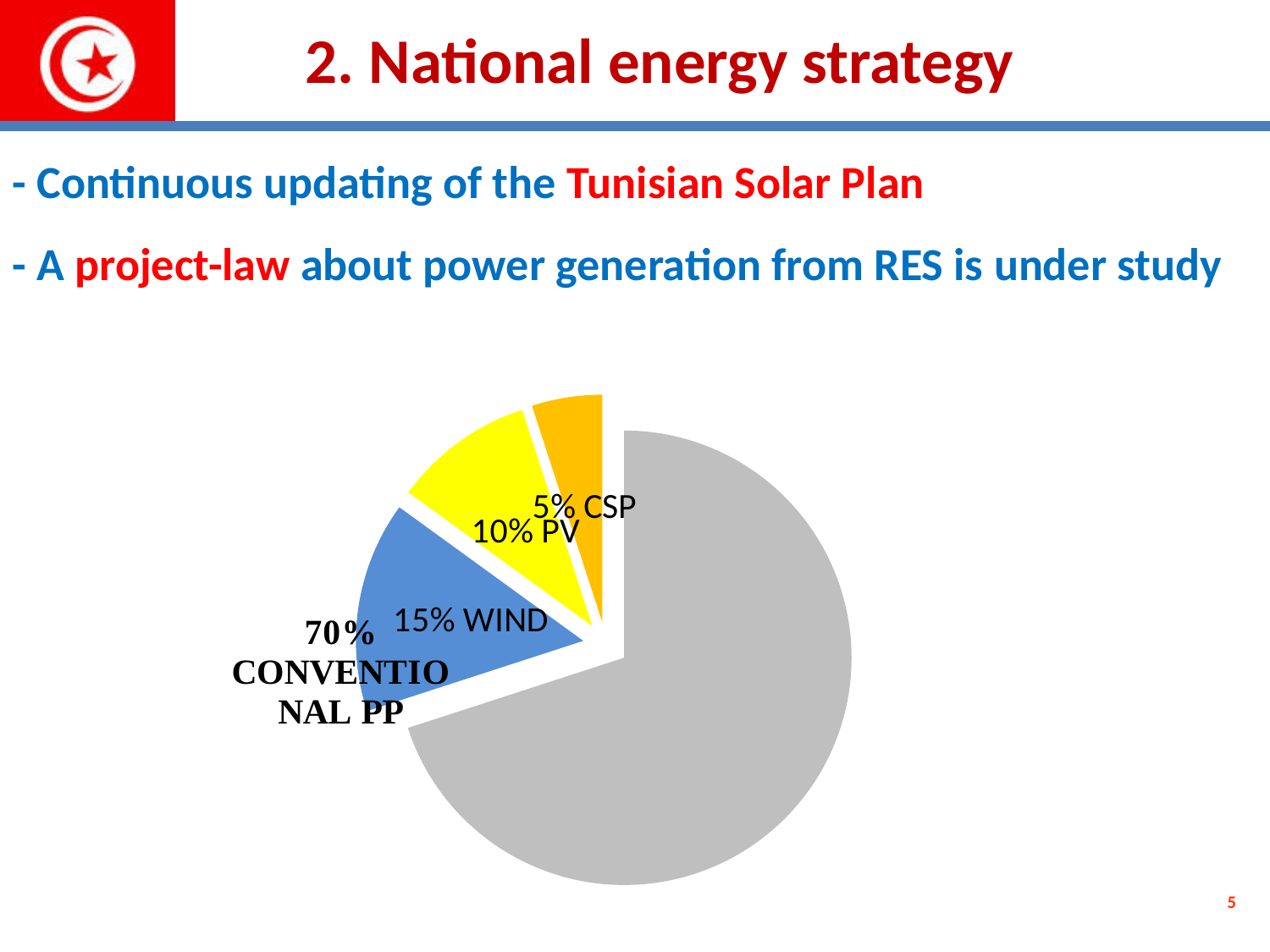
What share of the pie does WIND have? 15% What is the difference in percentage points between the CONVENTIONAL PP share and the WIND share? 55% Which slice of the pie is the smallest? CSP What share of the pie does CONVENTIONAL PP have? 70% What is the difference in percentage points between the WIND share and the PV share? 5% Which slice of the pie is the largest? CONVENTIONAL PP How many slices does the pie chart have? 4 What share of the pie does CSP have? 5% Which is larger, the PV share or the CSP share? PV What kind of chart is shown on the slide? pie chart What colour is the CONVENTIONAL PP slice? grey